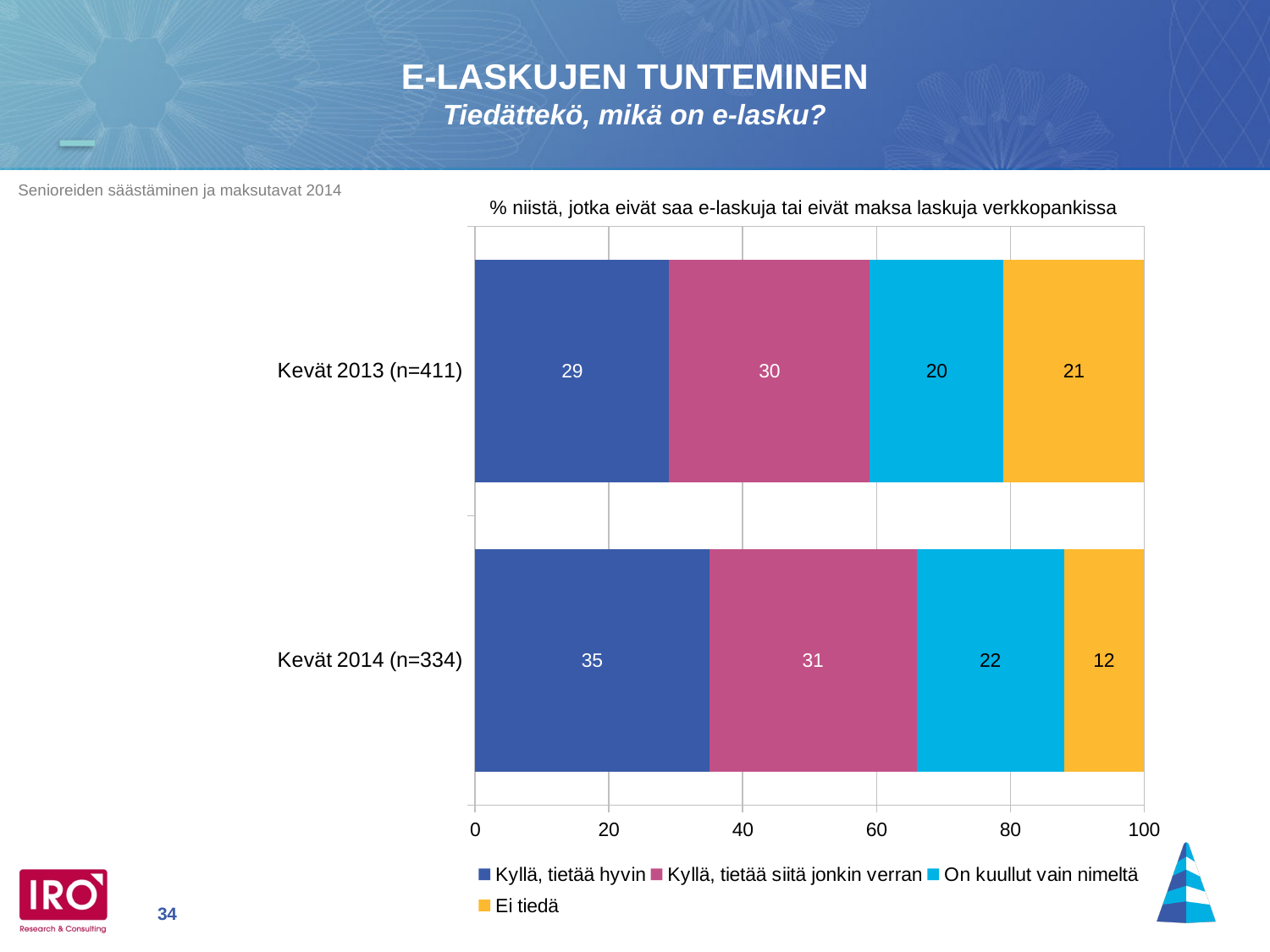
What is the difference between the "Ei tiedä" values for Kevät 2013 (n=411) and Kevät 2014 (n=334)? 9 Which series has the highest value for Kevät 2014 (n=334)? Kyllä, tietää hyvin What is the value for "On kuullut vain nimeltä" for Kevät 2013 (n=411)? 20 What is the value for "Kyllä, tietää siitä jonkin verran" for Kevät 2014 (n=334)? 31 Which is larger: "Kyllä, tietää hyvin" for Kevät 2013 (n=411) or for Kevät 2014 (n=334)? Kevät 2014 (n=334) What kind of chart is shown on the slide? Stacked bar chart How many series does the legend list? 4 Which series has the lowest value for Kevät 2013 (n=411)? On kuullut vain nimeltä What is the total of the stacked bar for Kevät 2013 (n=411)? 100 What is the value for "Kyllä, tietää hyvin" for Kevät 2013 (n=411)? 29 What is the value for "Ei tiedä" for Kevät 2014 (n=334)? 12 How many categories (bars) are shown in the chart? 2